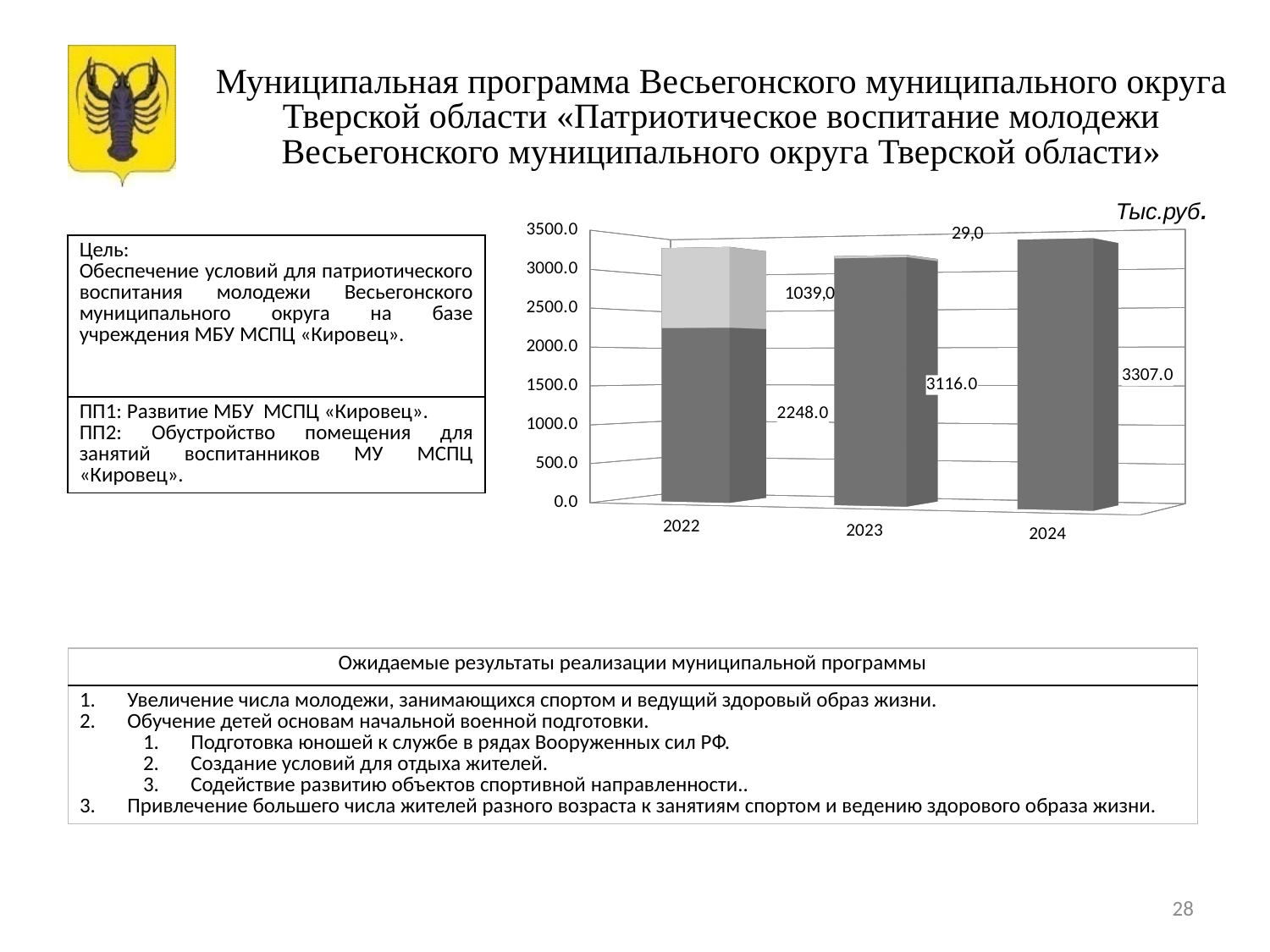
What unit is indicated above the chart? Тыс.руб. What is the value of the dark (lower) segment of the bar for 2022? 2248.0 What is the value of the light (upper) segment of the bar for 2022? 1039,0 What type of chart is shown on the slide? bar chart Do the dark (lower) segment values rise or fall from 2022 to 2024? rise What is the difference between the dark segment values for 2024 and 2023? 191.0 What is the value labelled on the bar for 2024? 3307.0 What is the value of the dark (lower) segment of the bar for 2023? 3116.0 Which year has the highest value for the dark (lower) segment? 2024 Is the dark segment value for 2023 larger or smaller than the dark segment value for 2022? larger Which year has the lowest value for the dark (lower) segment? 2022 How many years are shown on the x axis of the chart? 3